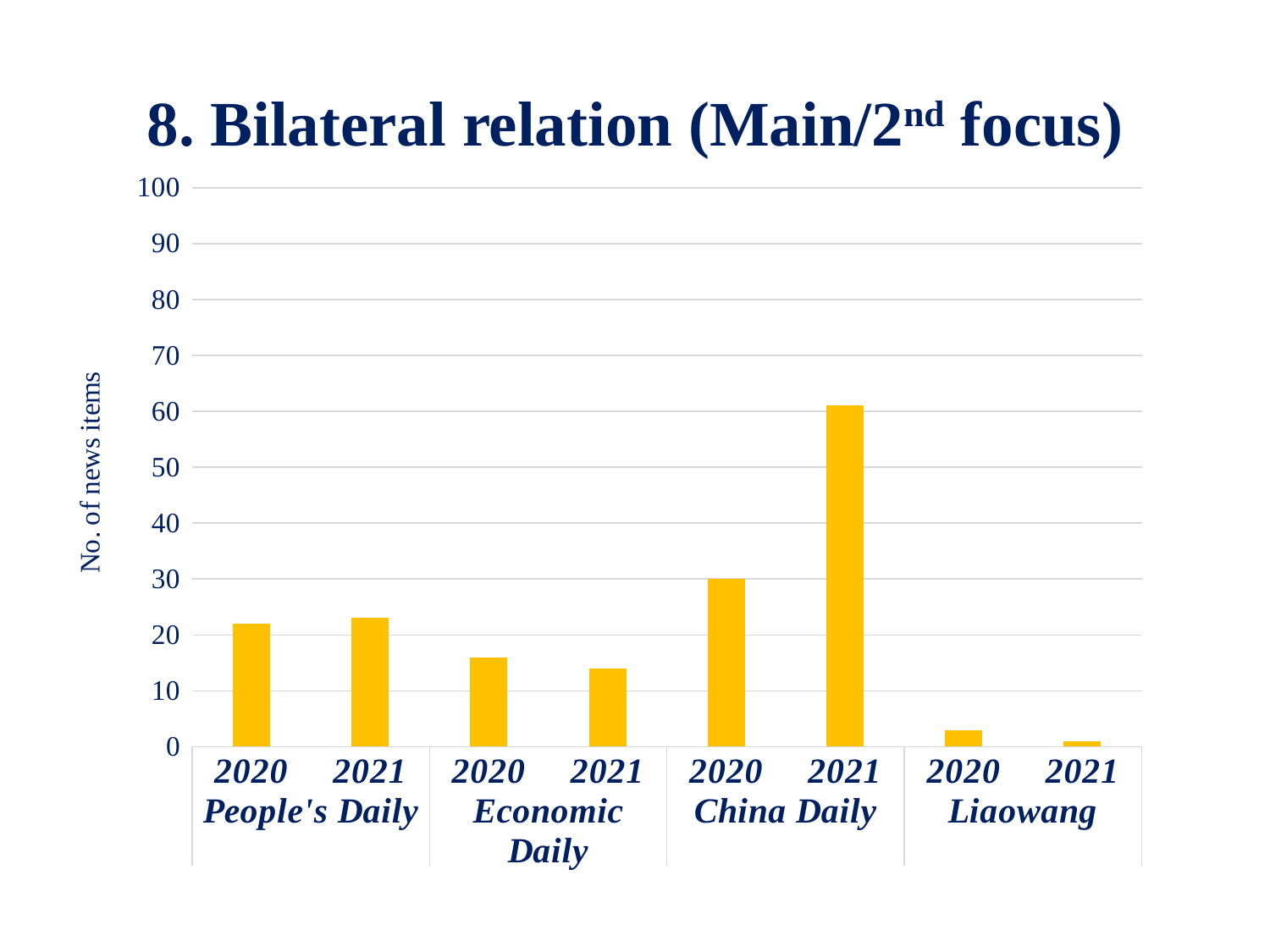
Which bar is the highest in the chart? China Daily 2021 Which is larger: the value for Liaowang 2020 or the value for Liaowang 2021? Liaowang 2020 How many newspapers are shown on the x axis of the chart? 4 What kind of chart is shown on the slide? bar chart What is the label on the vertical axis of the chart? No. of news items Which bar is the lowest in the chart? Liaowang 2021 Is the value for People's Daily 2020 greater or less than 20? greater Is the value for Economic Daily 2021 greater or less than 20? less How many bars are plotted in the chart? 8 Which is larger: the value for China Daily 2021 or the value for People's Daily 2021? China Daily 2021 Is the value for China Daily 2021 greater or less than 50? greater